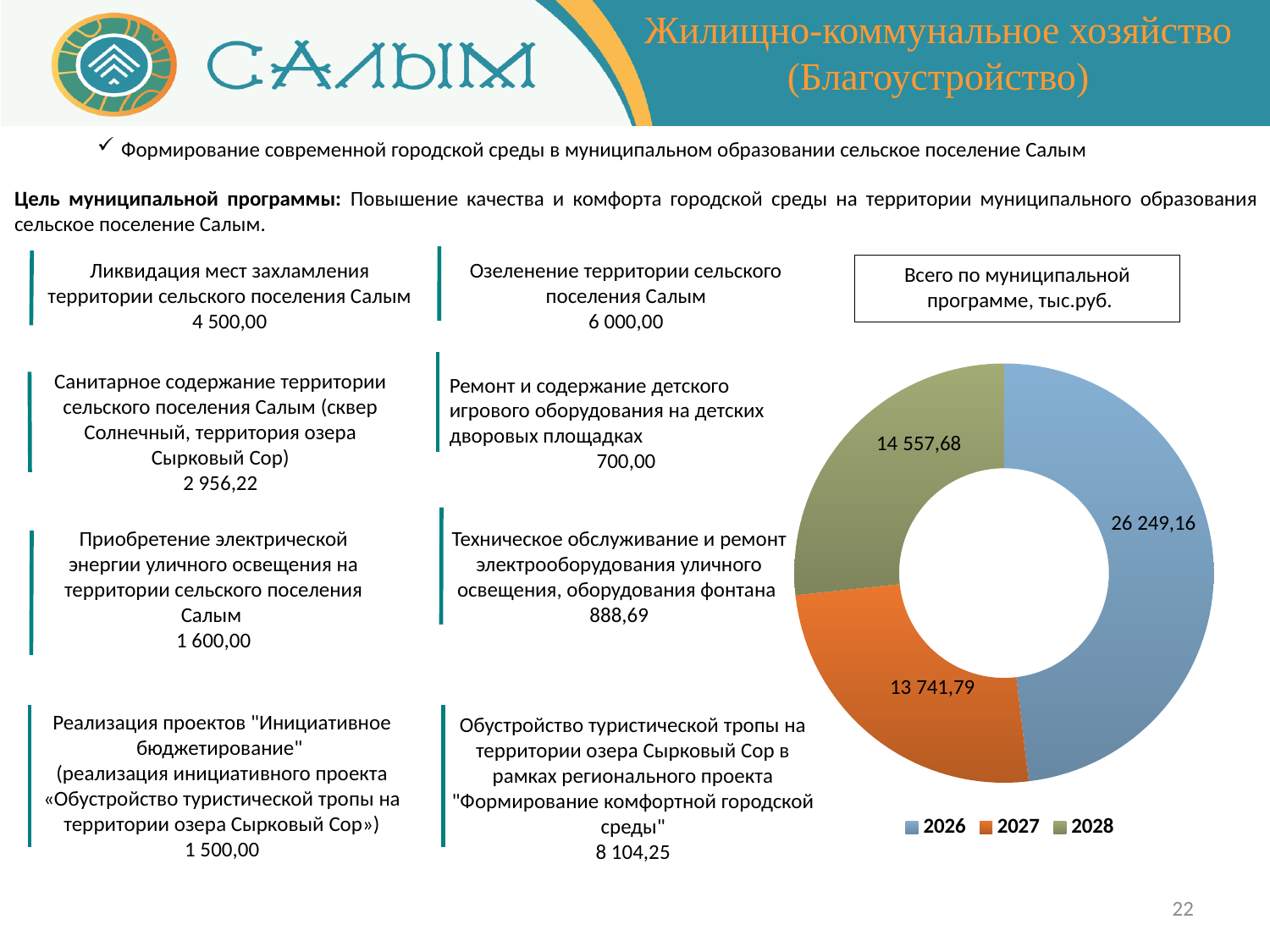
How many slices does the doughnut chart have? 3 Which year has the largest value in the doughnut chart? 2026 What is the difference between the values for 2026 and 2027 in the doughnut chart? 12 507,37 What is the value for 2028 in the doughnut chart? 14 557,68 What is the difference between the values for 2028 and 2027 in the doughnut chart? 815,89 What type of chart is shown on the slide? Doughnut chart What is the value for 2026 in the doughnut chart? 26 249,16 How many entries does the legend of the doughnut chart list? 3 What is the title shown above the doughnut chart? Всего по муниципальной программе, тыс.руб. Which year has the smallest value in the doughnut chart? 2027 Which is larger in the doughnut chart, the value for 2027 or for 2028? 2028 What is the value for 2027 in the doughnut chart? 13 741,79